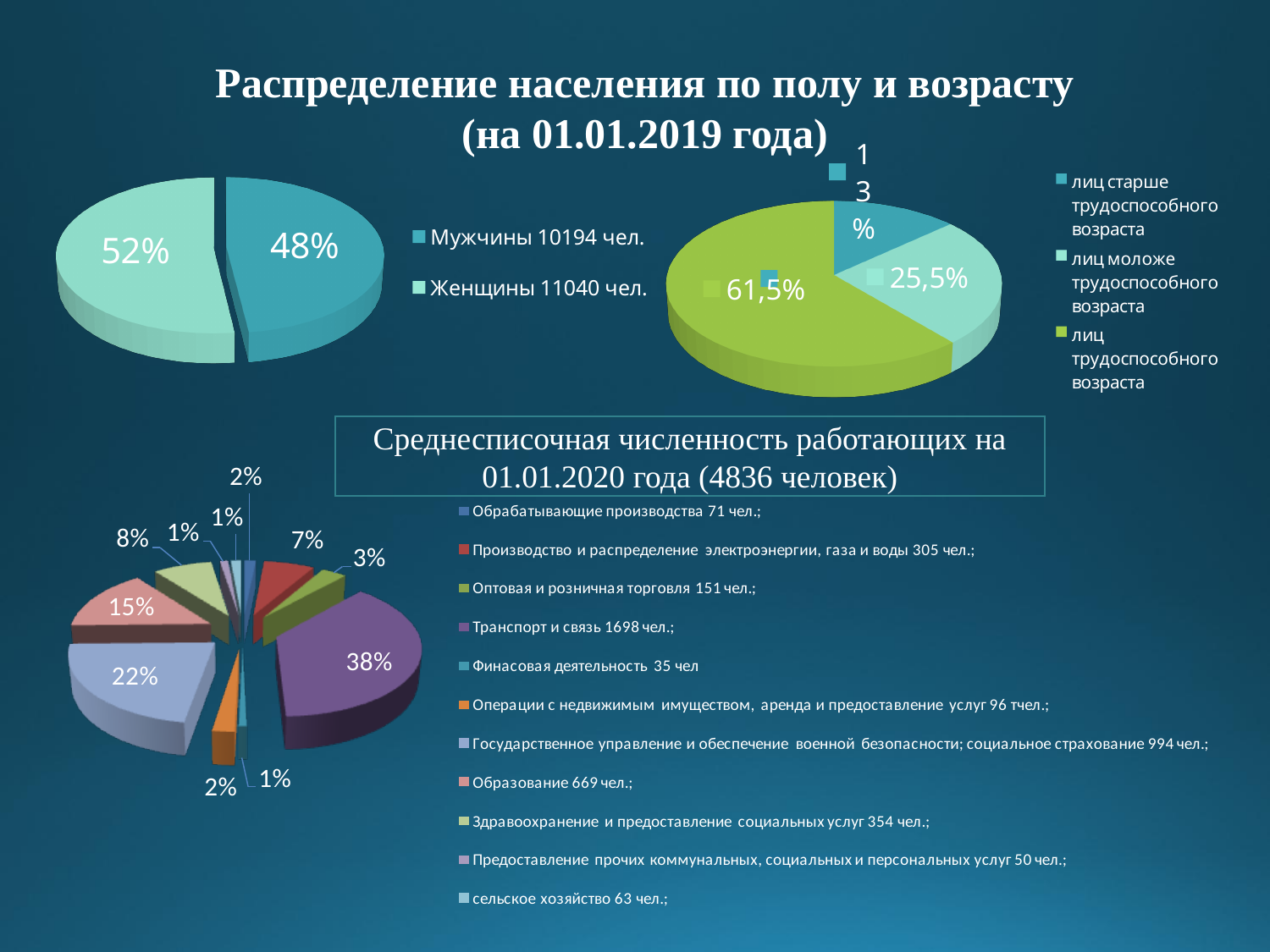
What type of chart is the top-left chart? Pie chart In the top-left pie chart, how many people are listed for Мужчины in the legend? 10194 чел. In the top-left pie chart, which group has the larger share, Мужчины or Женщины? Женщины How many categories does the top-right pie chart have? 3 In the top-right pie chart, what share is shown for лиц моложе трудоспособного возраста? 25,5% In the top-left pie chart, what share is shown for Мужчины? 48% In the top-left pie chart, what is the difference between the shares for Женщины and Мужчины? 4% In the bottom pie chart (Среднесписочная численность работающих), what is the largest slice's percentage? 38% In the bottom chart's legend, how many people are listed for Транспорт и связь? 1698 чел. How many categories does the legend of the bottom pie chart (Среднесписочная численность работающих) list? 11 In the top-right pie chart, what share is shown for лиц трудоспособного возраста? 61,5% In the top-right pie chart, which category has the largest share? лиц трудоспособного возраста